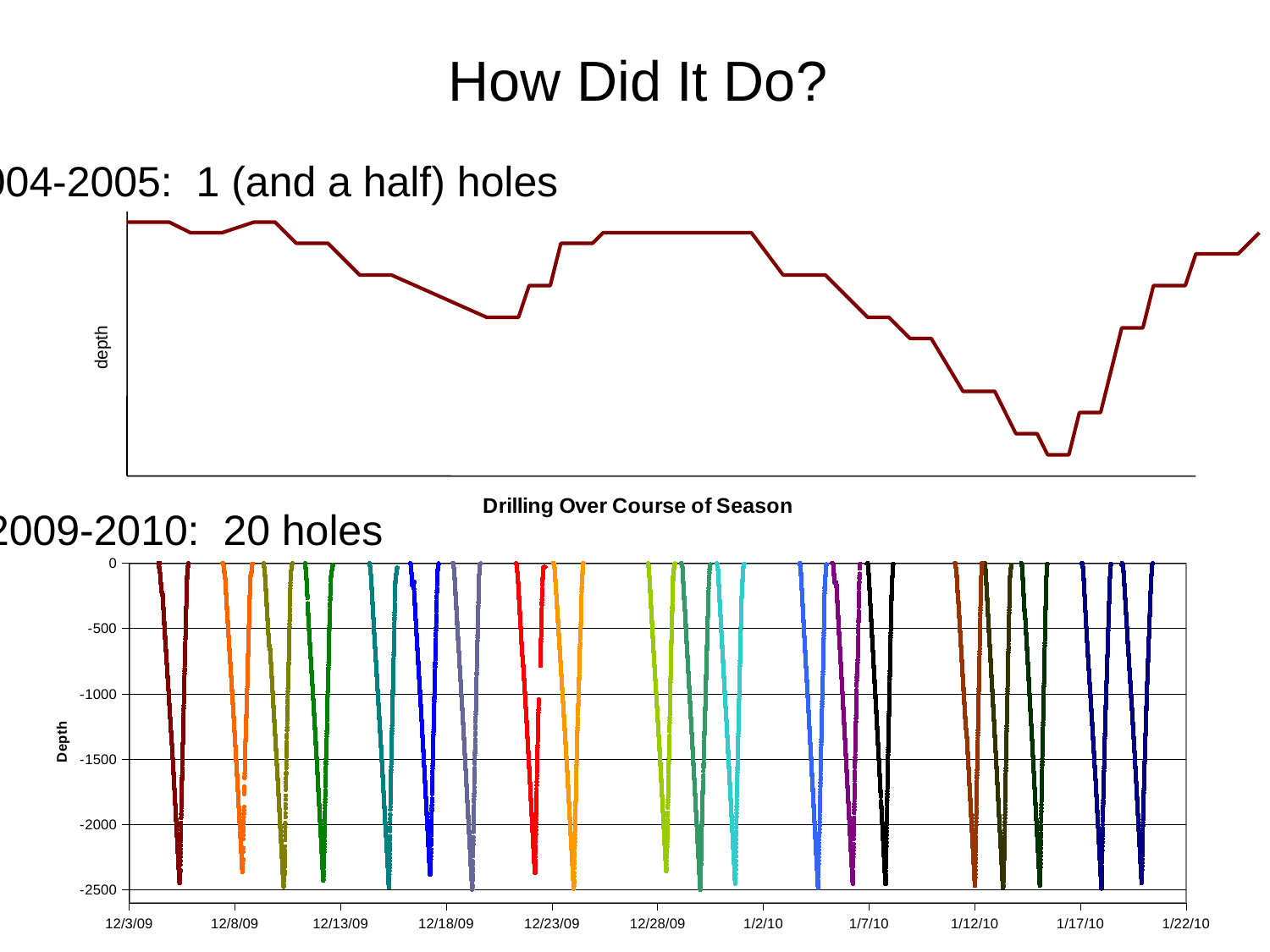
What is the y-axis label of the top chart? depth How many charts are shown on the slide? 2 In the bottom chart 'Drilling Over Course of Season', does the first (dark red) hole reach deeper than -2000? yes In the bottom chart 'Drilling Over Course of Season', what is the first date label on the x axis? 12/3/09 How many tick labels are shown on the Depth axis of the bottom chart 'Drilling Over Course of Season'? 6 In the bottom chart 'Drilling Over Course of Season', what is the y-axis label? Depth How many date labels are shown on the x axis of the bottom chart 'Drilling Over Course of Season'? 11 In the bottom chart 'Drilling Over Course of Season', what is the last date label on the x axis? 1/22/10 In the bottom chart 'Drilling Over Course of Season', what is the lowest value shown on the Depth axis? -2500 What is the title of the bottom chart? Drilling Over Course of Season What kind of chart is the top chart (2004-2005)? line chart